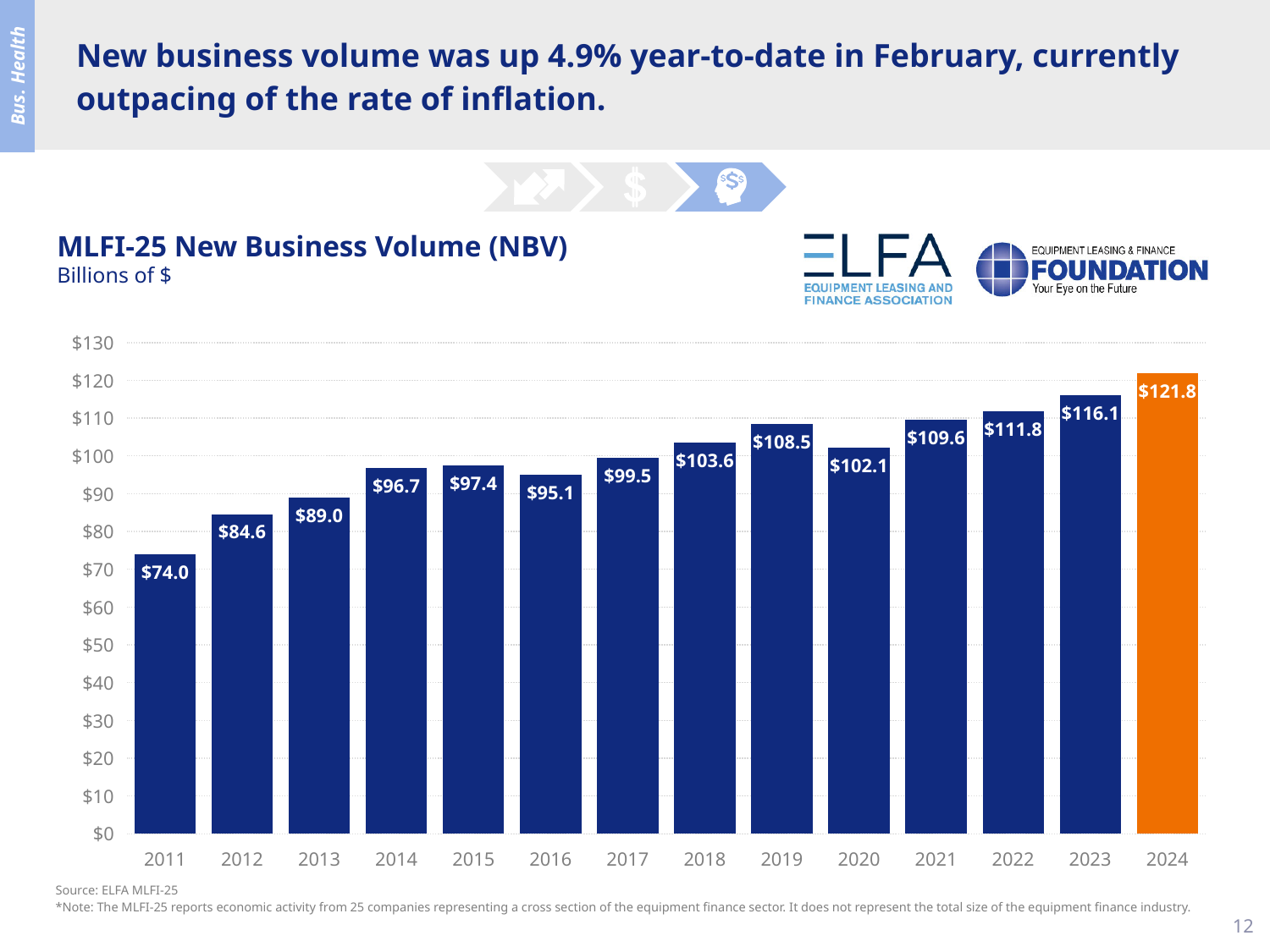
Is the New Business Volume for 2016 greater or less than $100? less What is the MLFI-25 New Business Volume for 2024? $121.8 Which year's bar is coloured orange instead of dark blue? 2024 Which year has the lowest MLFI-25 New Business Volume? 2011 Which year has a larger New Business Volume, 2019 or 2020? 2019 What kind of chart is used to show MLFI-25 New Business Volume? Bar chart What is the MLFI-25 New Business Volume for 2011? $74.0 How many years are shown on the x axis of the chart? 14 Which year has the highest MLFI-25 New Business Volume? 2024 What is the MLFI-25 New Business Volume for 2020? $102.1 What is the unit stated under the chart title? Billions of $ What is the difference between the New Business Volume in 2024 and in 2023? $5.7